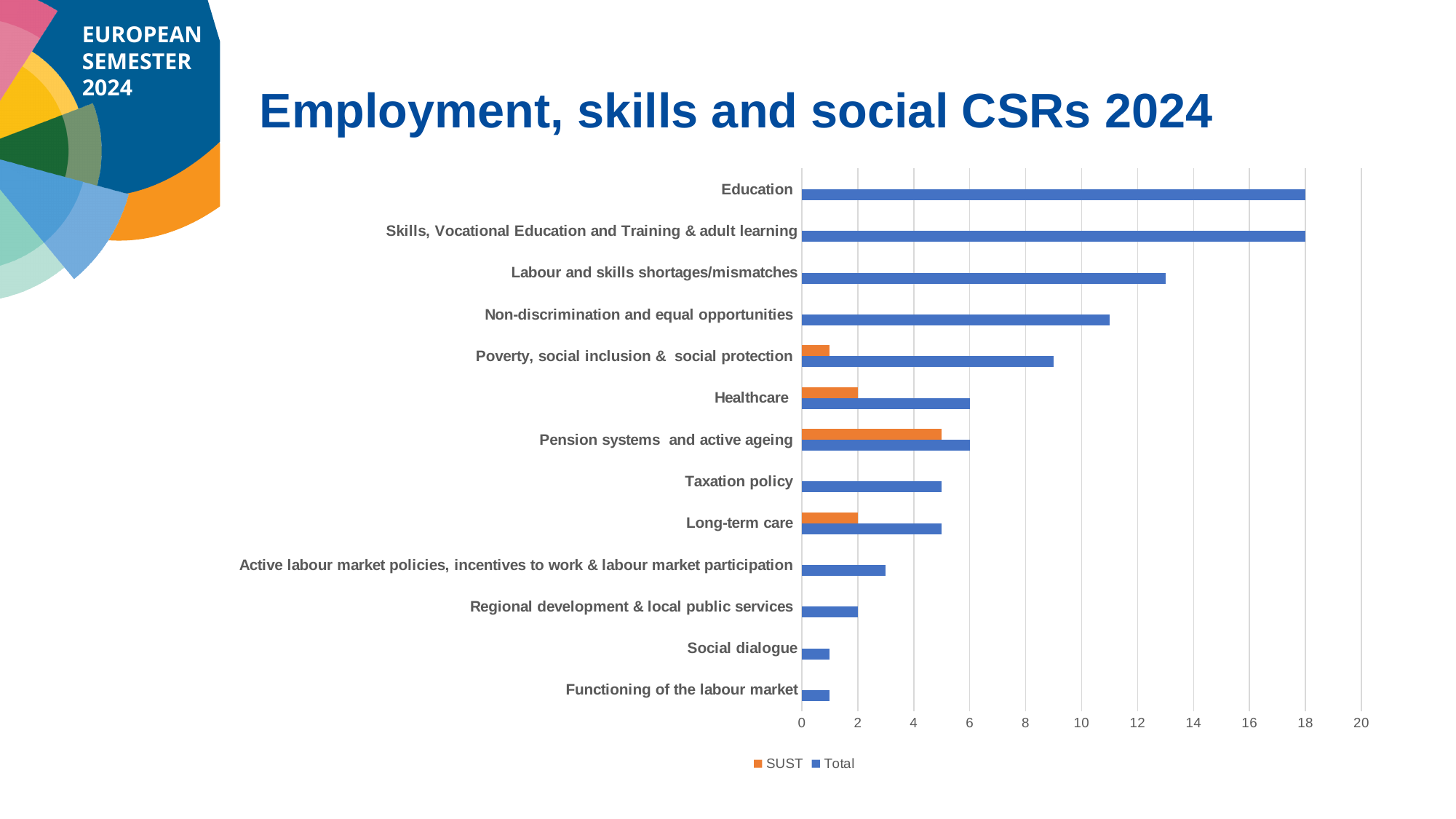
Which series is shown in orange in the legend? SUST How many categories are plotted on the chart? 13 What is the Total value for Education? 18 How many series does the legend list? 2 What is the SUST value for Long-term care? 2 What kind of chart is shown on the slide? bar chart Is the Total value for Labour and skills shortages/mismatches greater or less than 12? greater What is the Total value for Regional development & local public services? 2 Which category has the highest SUST value? Pension systems and active ageing What is the Total value for Healthcare? 6 Which is larger, the Total value for Taxation policy or the Total value for Healthcare? Healthcare Is the Total value for Non-discrimination and equal opportunities greater or less than 12? less